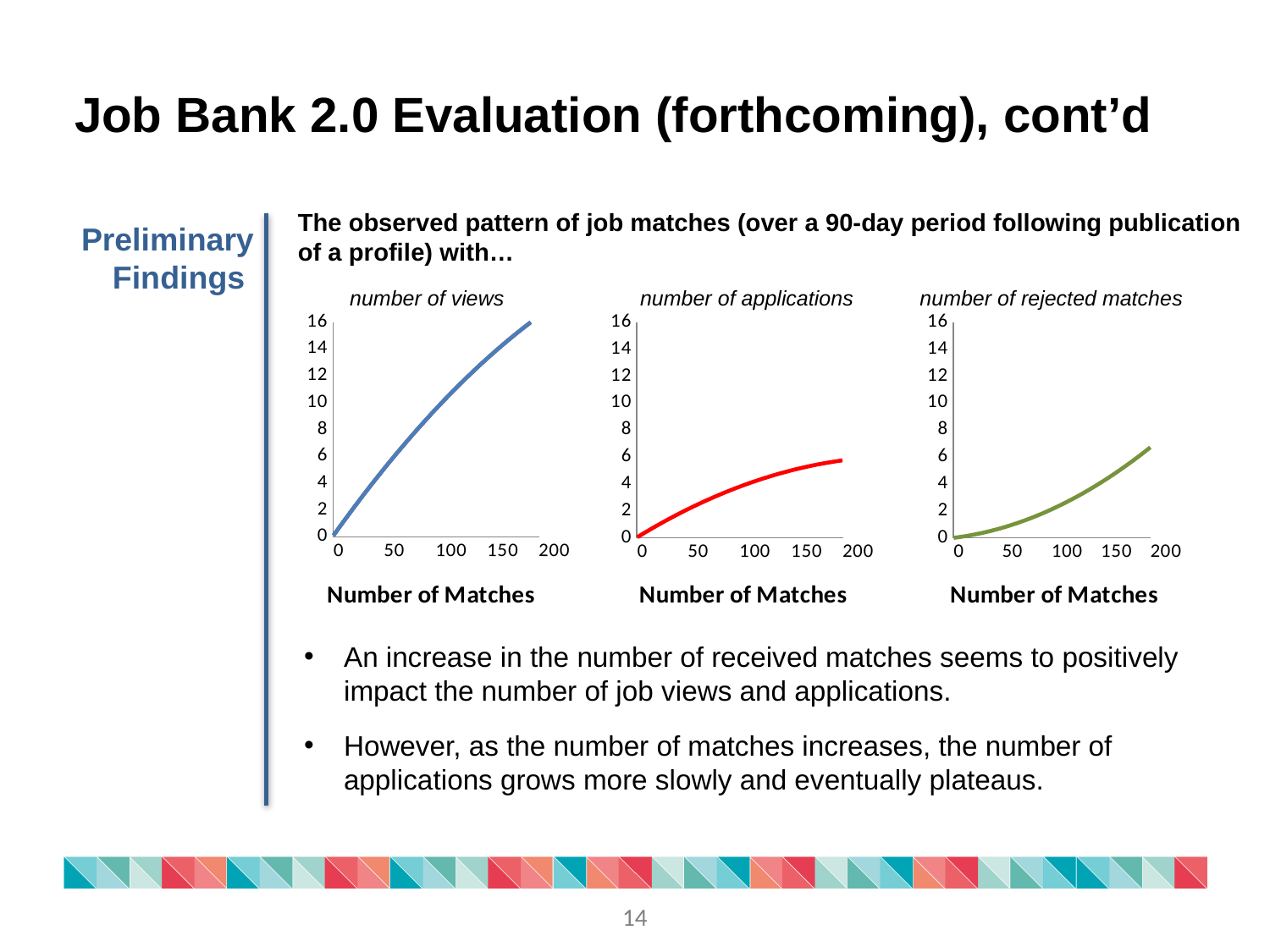
Which of the three charts reaches the highest value on its y axis? number of views In the "number of views" chart, is the value at 150 matches greater or less than 12? greater How many charts are shown on the slide? 3 In the "number of rejected matches" chart, do the values rise or fall as the number of matches increases? rise What is the x-axis label shared by the three charts? Number of Matches In the "number of rejected matches" chart, is the value at 100 matches greater or less than 4? less In the "number of applications" chart, is the value at 100 matches greater or less than 6? less In the "number of applications" chart, do the values rise or fall as the number of matches increases? rise In the "number of views" chart, do the values rise or fall as the number of matches increases? rise At 150 matches, which is larger: the value in the "number of views" chart or the value in the "number of applications" chart? number of views What kind of chart is the "number of views" chart? line chart